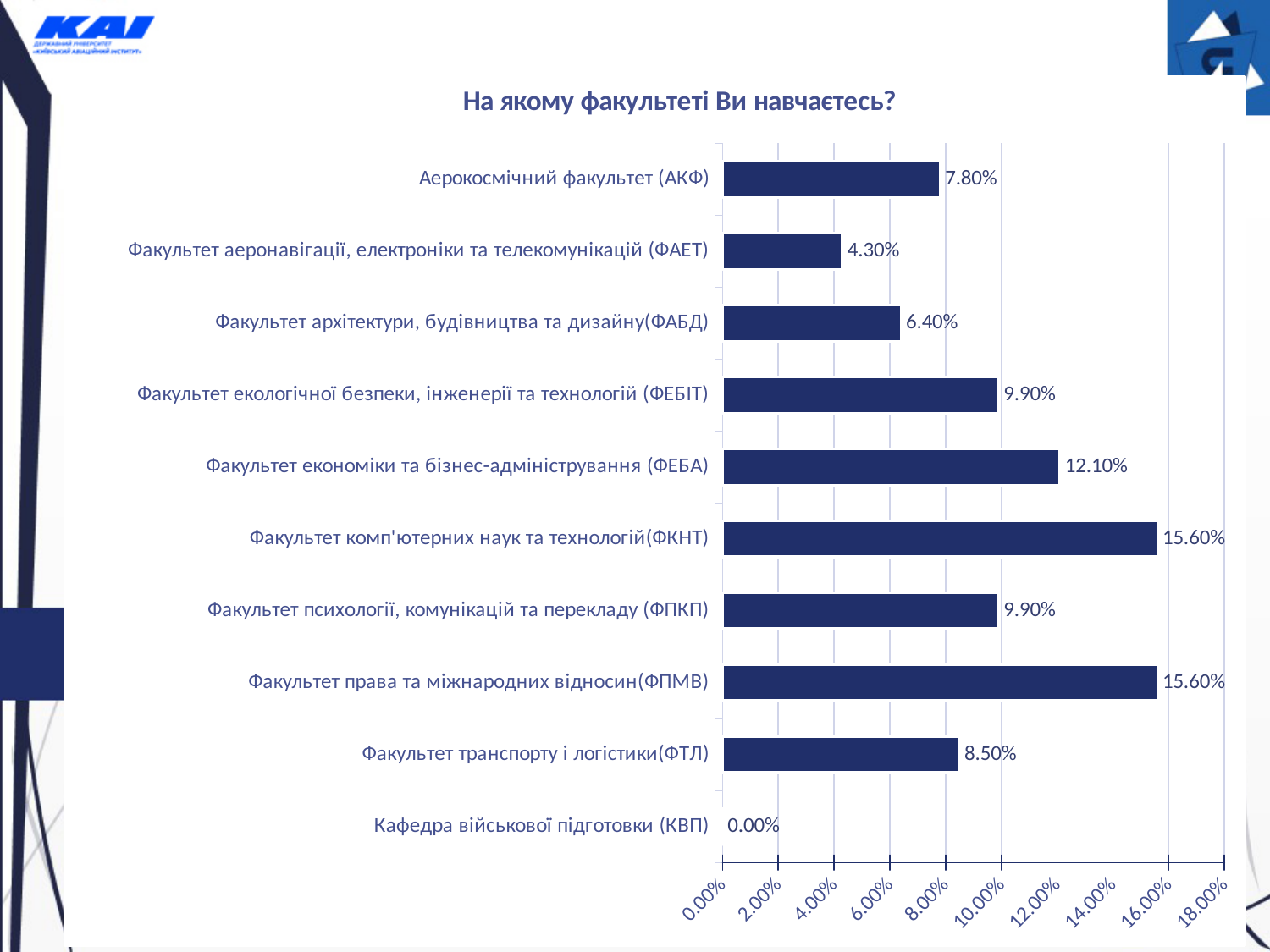
What is the title of the chart? На якому факультеті Ви навчаєтесь? Is the value for Факультет комп'ютерних наук та технологій (ФКНТ) greater or less than 14.00%? greater What is the value for Факультет економіки та бізнес-адміністрування (ФЕБА)? 12.10% What is the difference between the values for ФЕБА and ФАЕТ? 7.80% What type of chart is shown on the slide? bar chart Which is larger, the value for ФЕБІТ or the value for ФАБД? ФЕБІТ How many categories are shown in the chart? 10 What is the value for Факультет транспорту і логістики (ФТЛ)? 8.50% What is the value for Аерокосмічний факультет (АКФ)? 7.80% What is the highest value shown in the chart? 15.60% What is the difference between the values for ФПМВ and ФТЛ? 7.10% Which category has the lowest value? Кафедра військової підготовки (КВП)